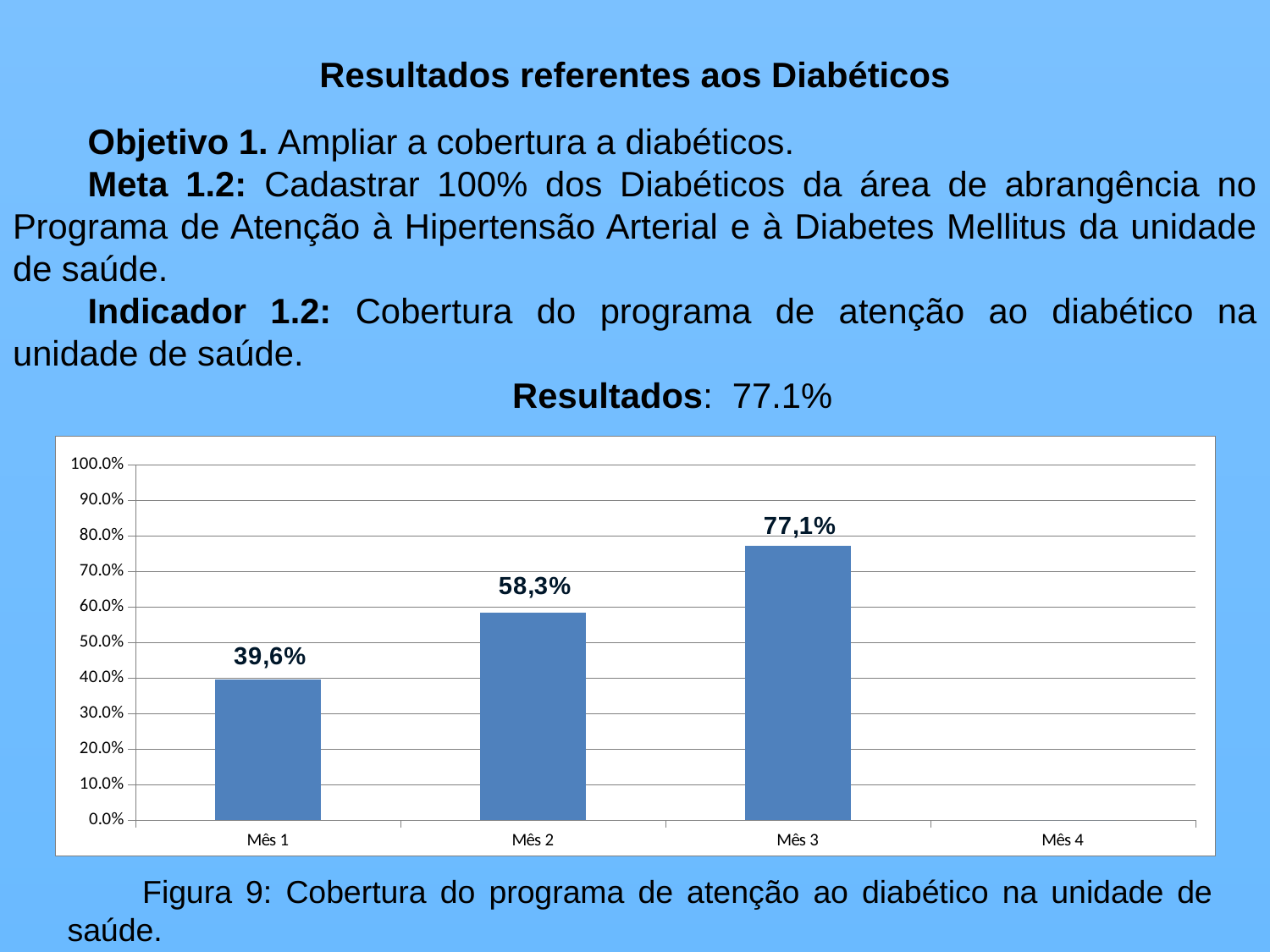
What is the value for Mês 2? 58,3% Do the values rise or fall from Mês 1 to Mês 3? Rise What is the difference between the values for Mês 3 and Mês 1? 37,5% Which is larger, the value for Mês 2 or the value for Mês 1? Mês 2 What kind of chart is shown on the slide? Bar chart What is the value for Mês 3? 77,1% How many bars are plotted in the chart? 3 Which month has the highest value? Mês 3 What is the difference between the values for Mês 3 and Mês 2? 18,8% Is the value for Mês 3 greater or less than 80.0%? less Which month with a plotted bar has the lowest value? Mês 1 What is the value for Mês 1? 39,6%